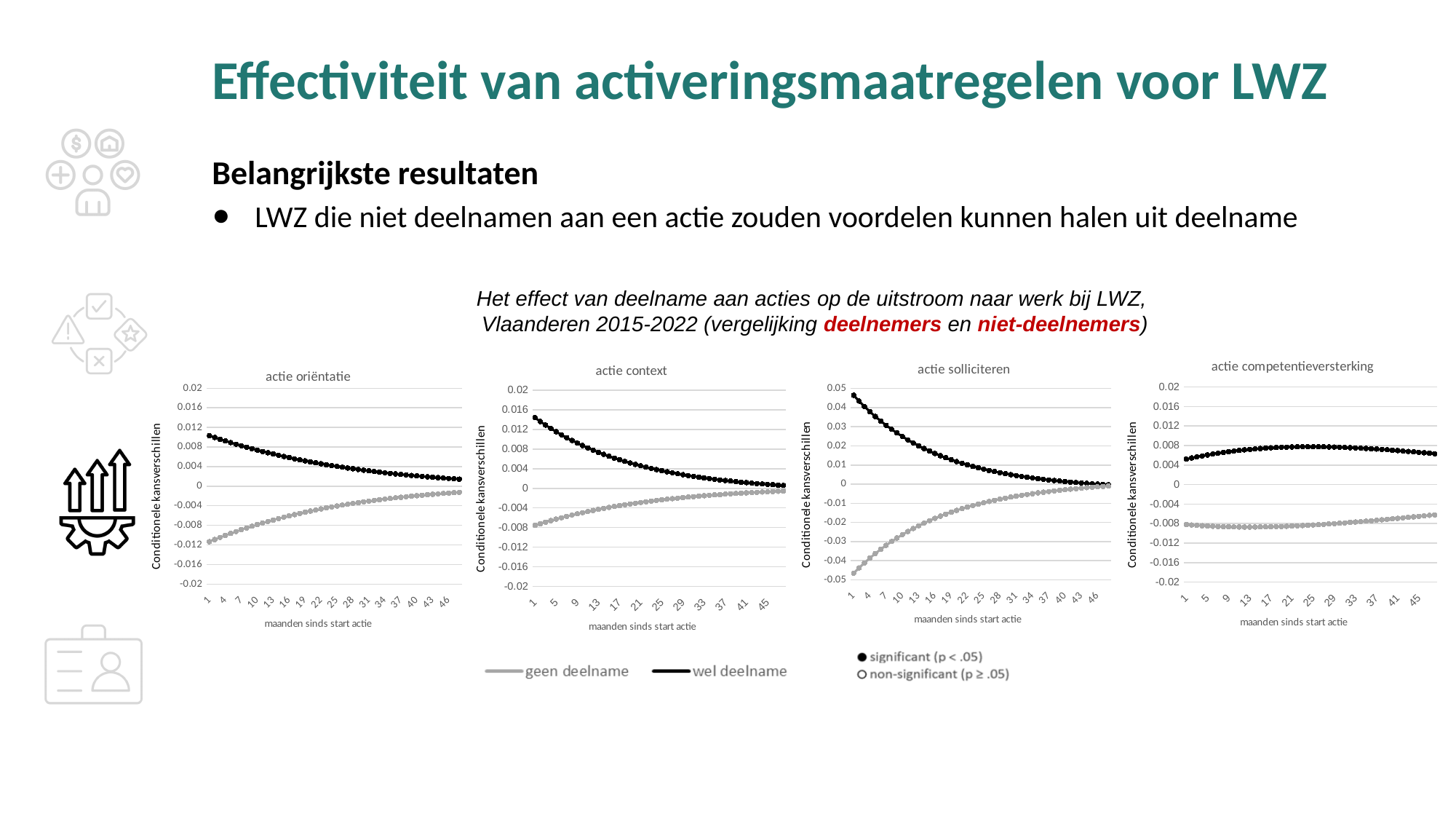
How many series does the shared legend below the charts list? 2 How many charts are shown on the slide? 4 In the 'actie oriëntatie' chart, is the value for 'geen deelname' at month 1 greater or less than -0.008? less What kind of chart is 'actie oriëntatie'? line chart In the 'actie oriëntatie' chart, does the 'geen deelname' series rise or fall as the months since the start of the action increase? rise In the 'actie context' chart, is the value for 'wel deelname' at month 1 greater or less than 0.012? greater In the 'actie oriëntatie' chart, does the 'wel deelname' series rise or fall as the months since the start of the action increase? fall In the 'actie competentieversterking' chart, is the value for 'wel deelname' at month 1 greater or less than 0.004? greater What is the x-axis title of the 'actie solliciteren' chart? maanden sinds start actie In the 'actie context' chart, which series is higher at month 1, 'wel deelname' or 'geen deelname'? wel deelname